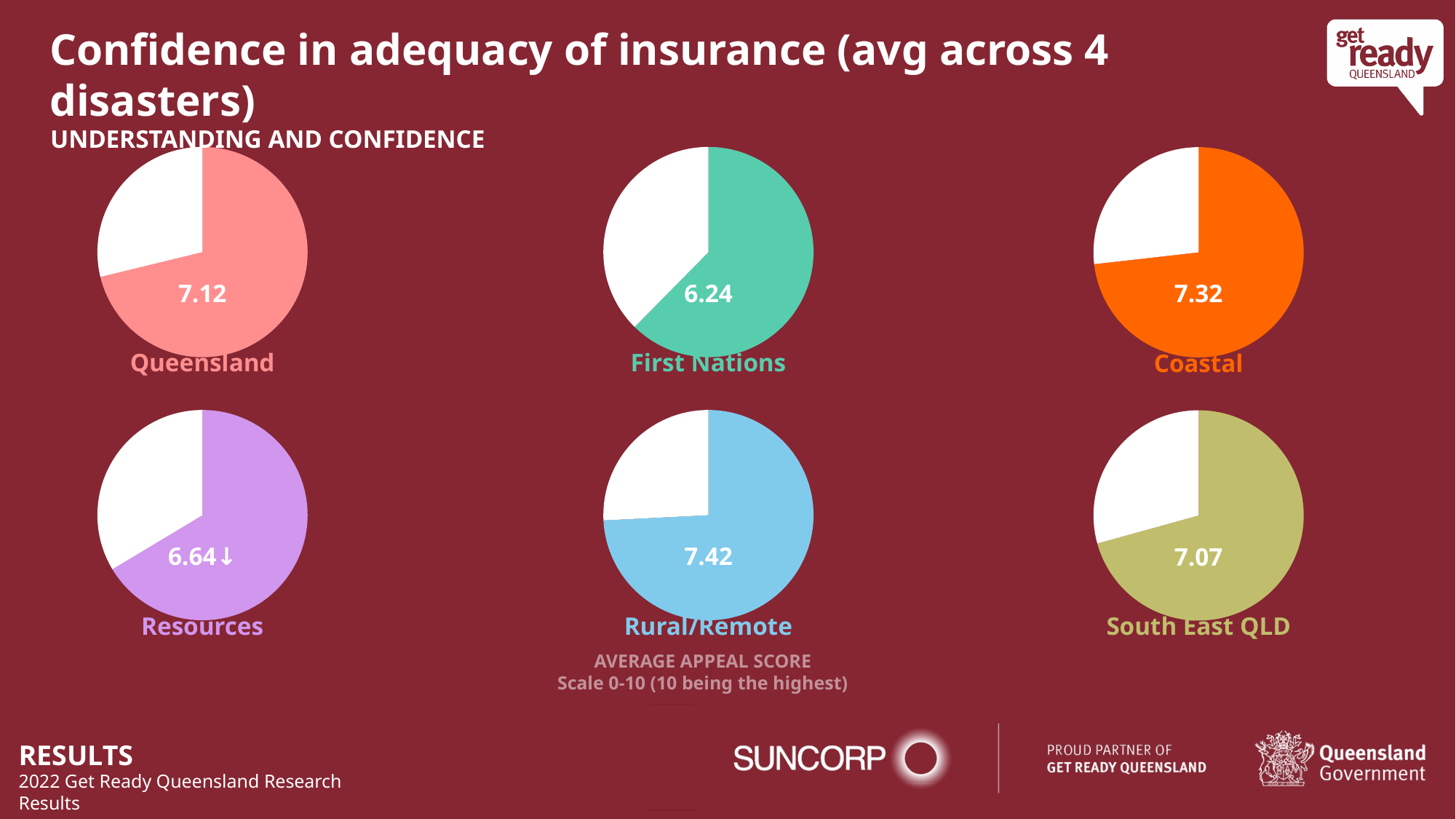
What is the score shown on the South East QLD pie chart? 7.07 What is the score shown on the Rural/Remote pie chart? 7.42 Which group has the lowest confidence score across the six pie charts? First Nations Which group has the highest confidence score across the six pie charts? Rural/Remote What is the score shown on the Queensland pie chart? 7.12 What is the difference between the Rural/Remote score and the First Nations score? 1.18 Which has a higher score, Resources or South East QLD? South East QLD What is the difference between the Coastal score and the Queensland score? 0.20 What is the score shown on the First Nations pie chart? 6.24 What colour is the Coastal pie chart's filled segment? Orange What kind of chart is used to show each group's score? Pie chart How many pie charts are shown on the slide? 6